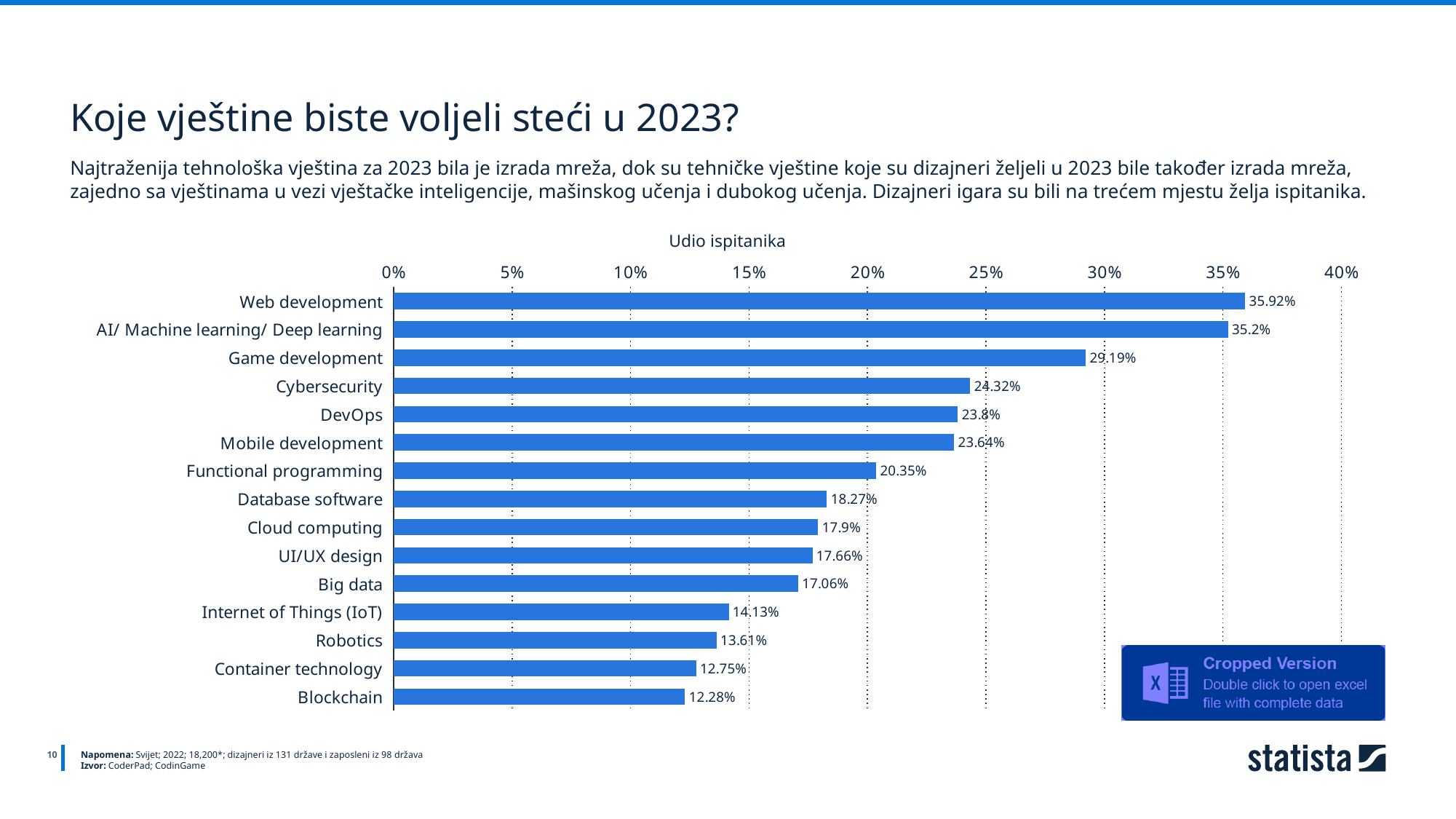
Is the value for Functional programming greater or less than 20%? greater What is the value for Blockchain? 12.28% What is the label of the horizontal axis of the chart? Udio ispitanika Which is larger, the value for Cloud computing or the value for Big data? Cloud computing What is the difference between the values for Web development and Game development? 6.73% What is the value for Web development? 35.92% What kind of chart is shown on the slide? bar chart What is the value for Cybersecurity? 24.32% Which category has the lowest value? Blockchain Which category has the highest value? Web development What is the difference between the values for Robotics and Container technology? 0.86% How many categories are shown in the chart? 15